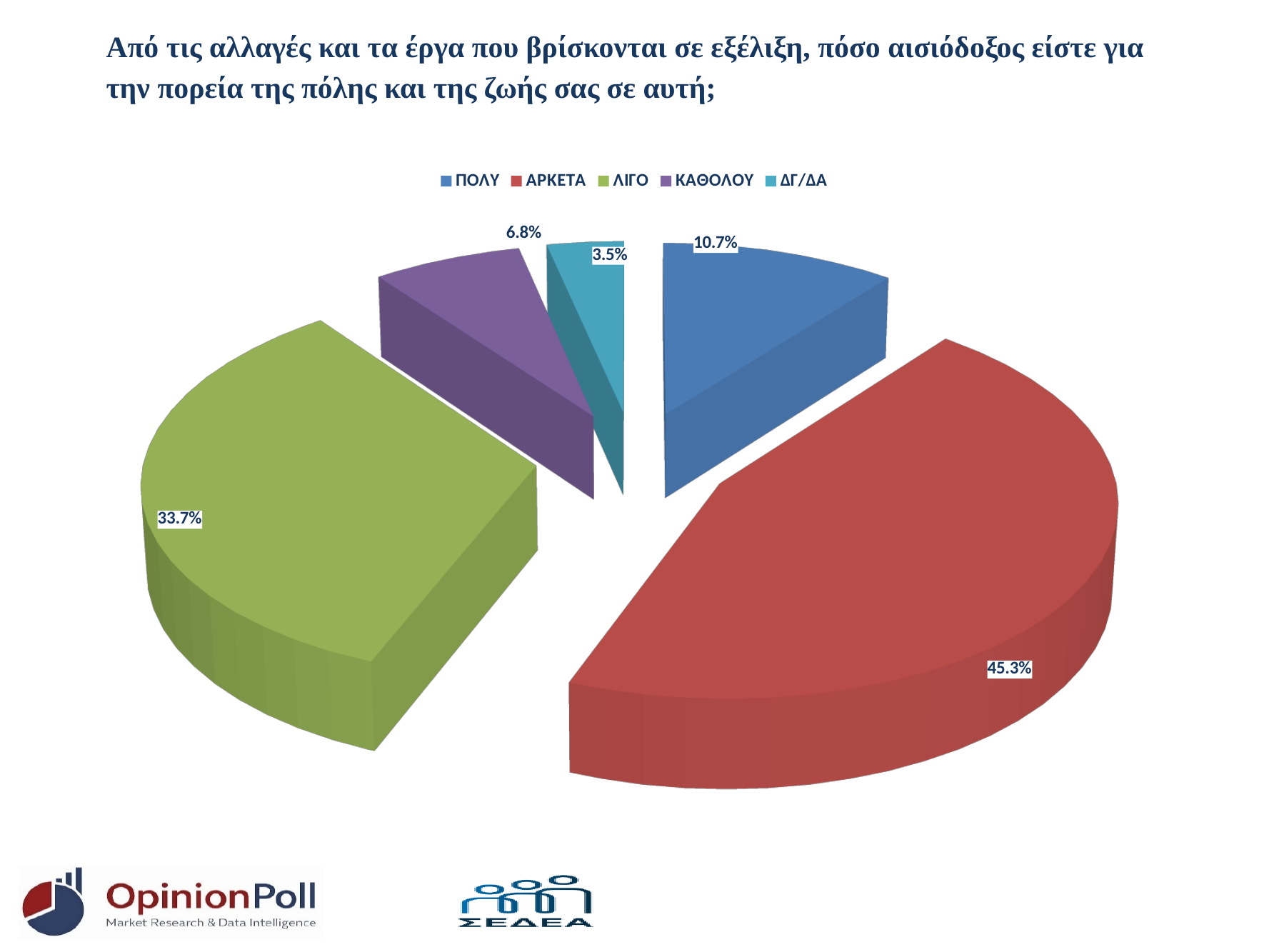
What percentage of respondents answered ΛΙΓΟ? 33.7% What colour is the slice for ΛΙΓΟ? Green What percentage of respondents answered ΑΡΚΕΤΑ? 45.3% Which response category has the smallest share of the pie? ΔΓ/ΔΑ How many categories does the legend list? 5 Which is larger, the share for ΠΟΛΥ or the share for ΚΑΘΟΛΟΥ? ΠΟΛΥ Which response category has the largest share of the pie? ΑΡΚΕΤΑ What percentage of respondents answered ΚΑΘΟΛΟΥ? 6.8% What percentage of respondents answered ΠΟΛΥ? 10.7% What is the difference in percentage points between ΑΡΚΕΤΑ and ΛΙΓΟ? 11.6 What percentage of respondents answered ΔΓ/ΔΑ? 3.5% What type of chart is shown on the slide? Pie chart